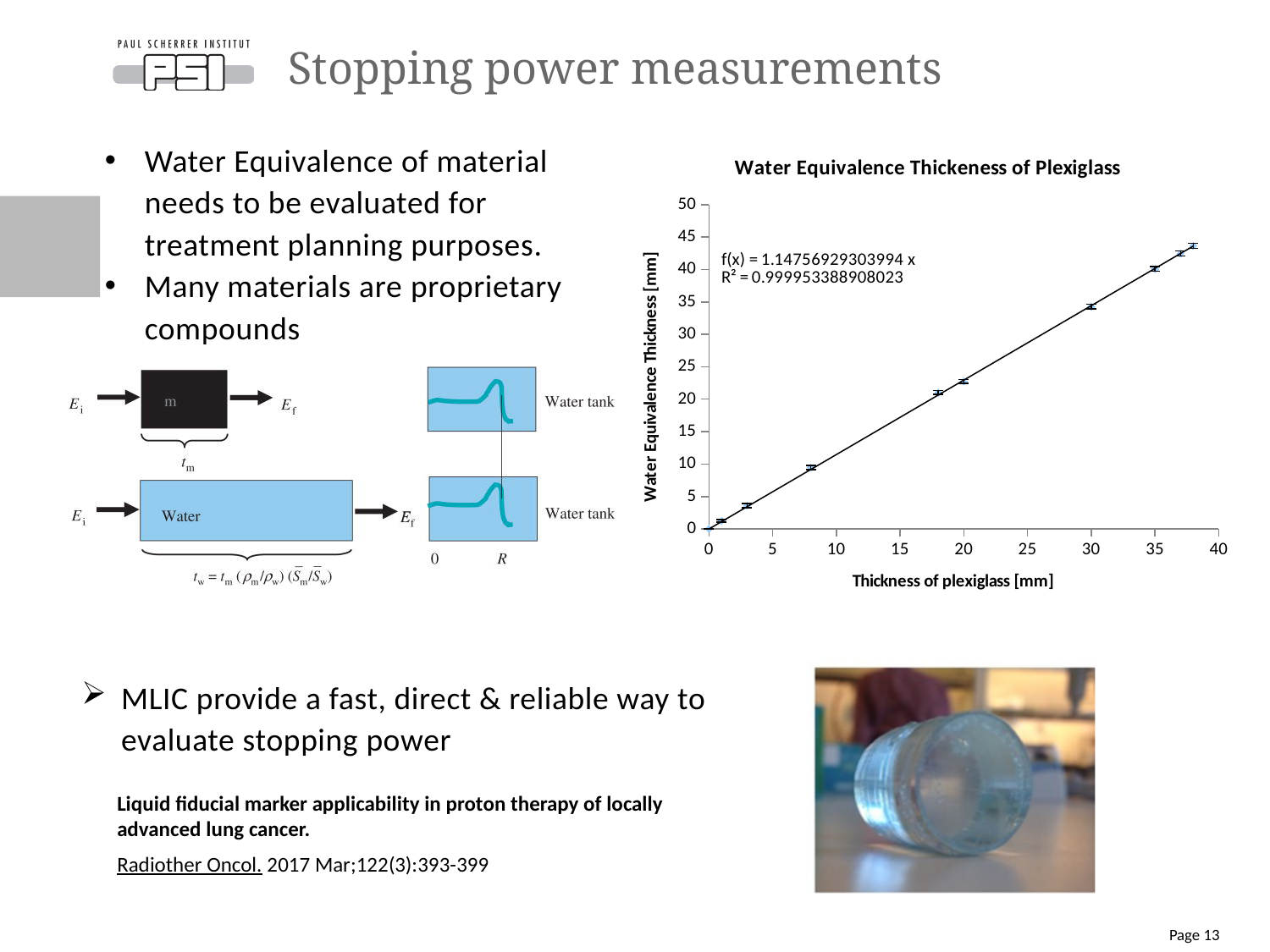
Is the water equivalence thickness at a plexiglass thickness of 30 mm greater or less than 30? greater What is the title of the chart? Water Equivalence Thickeness of Plexiglass What is the maximum value shown on the y axis of the chart? 50 What is the label of the x axis of the chart? Thickness of plexiglass [mm] Is the water equivalence thickness at a plexiglass thickness of 35 mm greater or less than 35? greater Do the plotted values rise or fall as the thickness of plexiglass increases? Rise Is the water equivalence thickness at a plexiglass thickness of 3 mm greater or less than 5? less What type of chart is shown on the slide? Scatter chart with a linear trendline Which has the larger water equivalence thickness: the point at 18 mm or the point at 30 mm of plexiglass? 30 mm